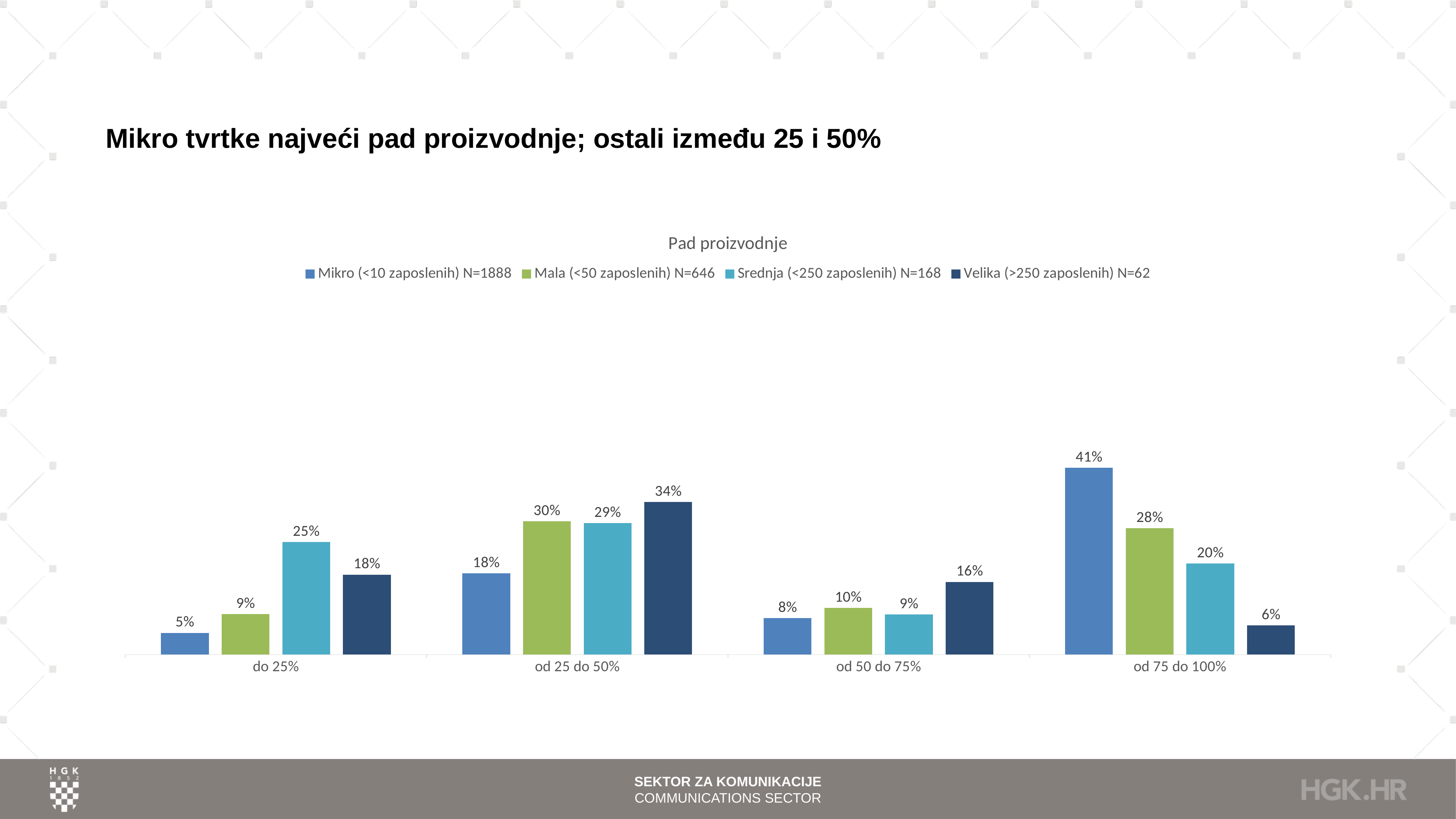
Which category has the lowest value for Velika (>250 zaposlenih)? od 75 do 100% What is the value for Velika (>250 zaposlenih) in the 'od 25 do 50%' category? 34% What kind of chart is shown on the slide? Bar chart Which category has the highest value for Mikro (<10 zaposlenih)? od 75 do 100% What is the difference between the Mikro and Velika values in the 'od 75 do 100%' category? 35% How many categories are shown on the x axis? 4 What is the value for Srednja (<250 zaposlenih) in the 'do 25%' category? 25% In the 'do 25%' category, which is larger: the value for Srednja or the value for Velika? Srednja What is the value for Mikro (<10 zaposlenih) in the 'od 75 do 100%' category? 41% How many series does the legend list? 4 What is the title of the chart? Pad proizvodnje What is the value for Mala (<50 zaposlenih) in the 'od 50 do 75%' category? 10%